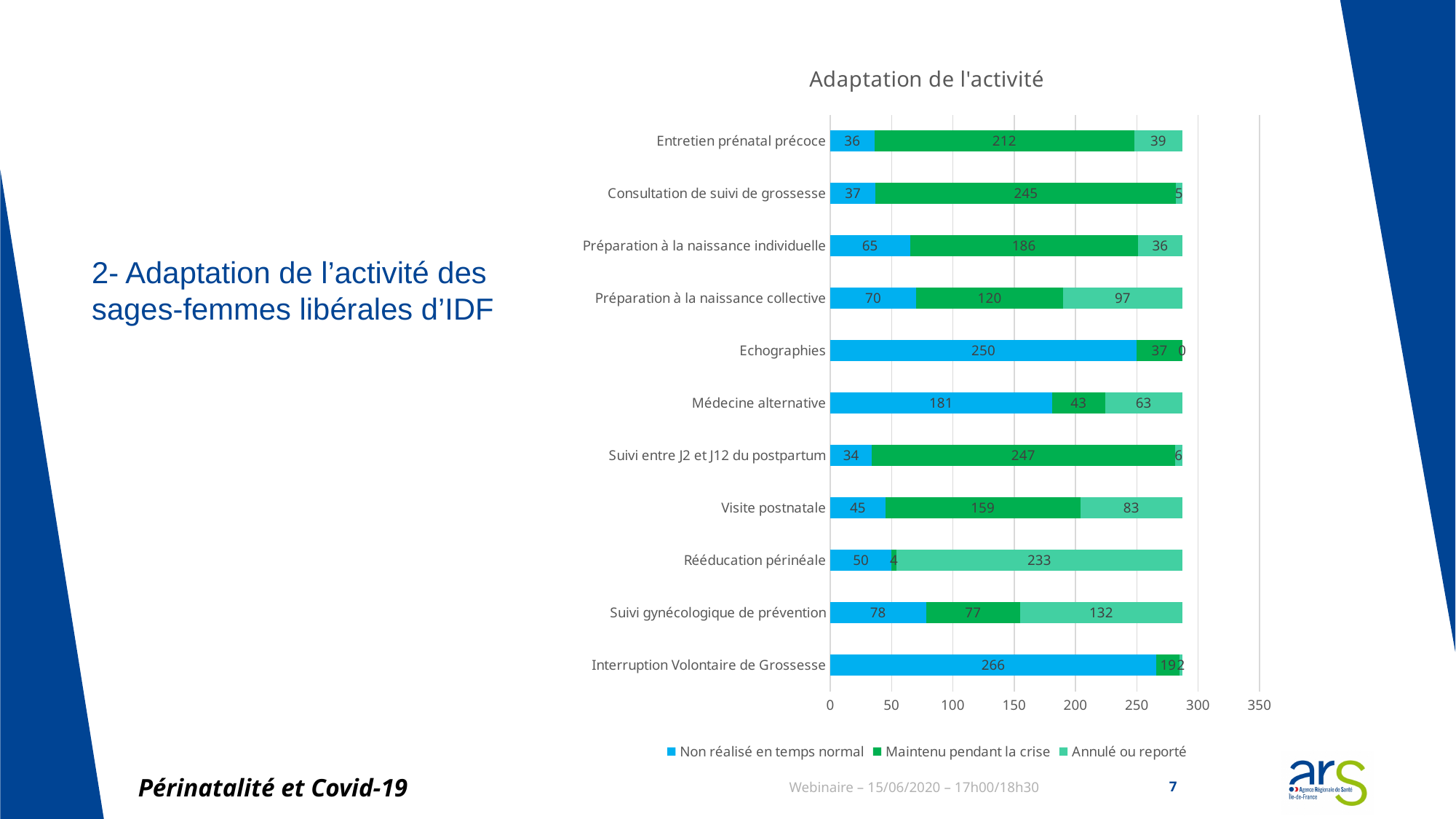
What is the value of 'Annulé ou reporté' for Rééducation périnéale? 233 Which is larger: the 'Maintenu pendant la crise' value for Visite postnatale or for Préparation à la naissance collective? Visite postnatale What kind of chart is shown on the slide? Stacked bar chart What is the value of 'Maintenu pendant la crise' for Consultation de suivi de grossesse? 245 Which category has the highest 'Annulé ou reporté' value? Rééducation périnéale How many categories are plotted on the chart? 11 What is the difference between the 'Annulé ou reporté' values for Préparation à la naissance collective and Préparation à la naissance individuelle? 61 What is the title of the chart? Adaptation de l'activité What is the total of the stacked bar for Suivi gynécologique de prévention? 287 What is the value of 'Non réalisé en temps normal' for Echographies? 250 How many series does the legend list? 3 Which category has the lowest 'Non réalisé en temps normal' value? Suivi entre J2 et J12 du postpartum